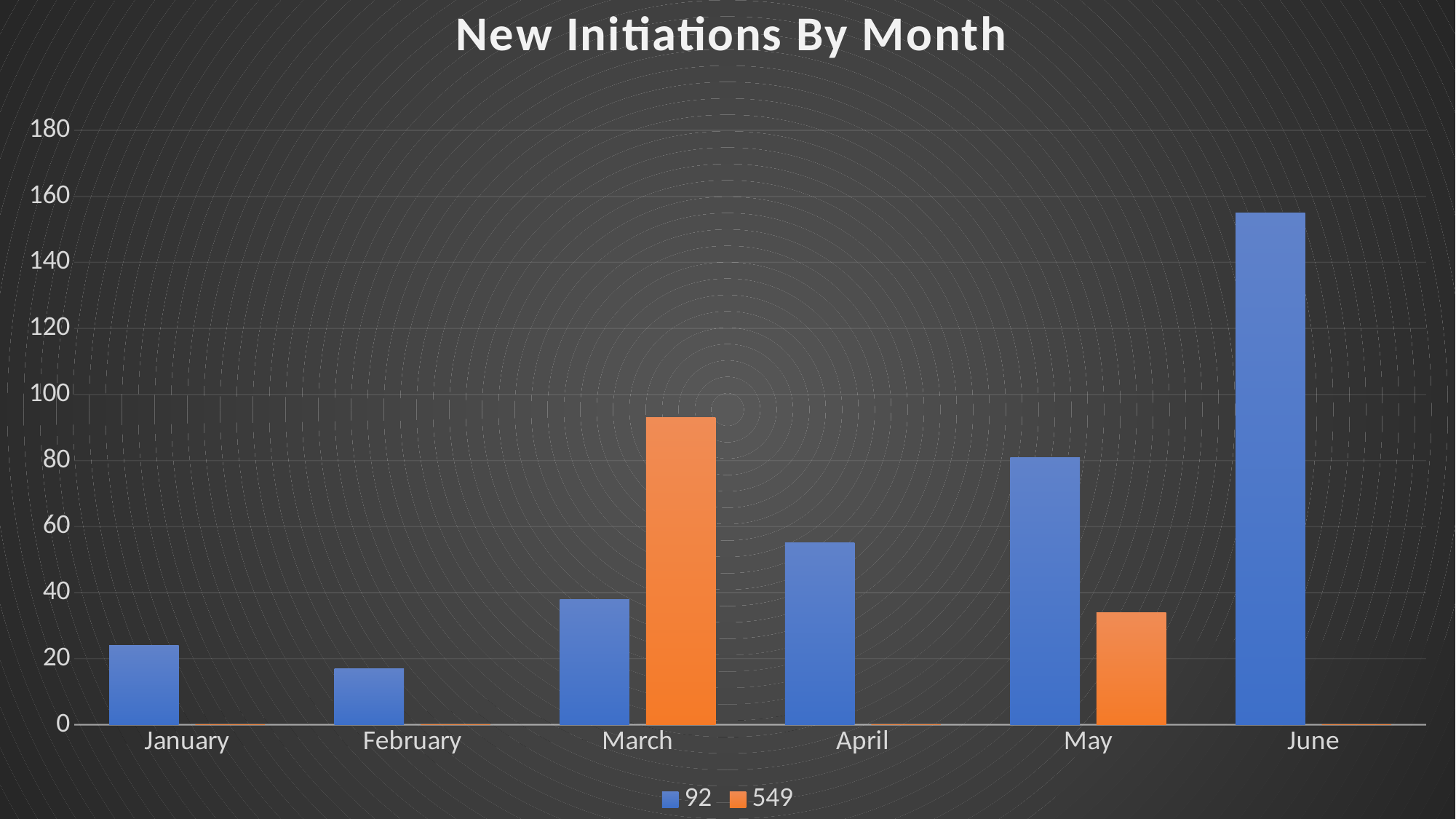
Is the value for June in the 92 series greater or less than 140? greater Is the value for January in the 92 series greater or less than 40? less What are the two series names shown in the legend? 92 and 549 Is the value for March in the 549 series greater or less than 80? greater Which month has the lowest value for the 92 series? February What is the title of the chart? New Initiations By Month In May, which series has the larger value, 92 or 549? 92 How many months are shown on the x axis? 6 Which month has the highest value for the 92 series? June How many series does the legend list? 2 In March, which series has the larger value, 92 or 549? 549 What kind of chart is shown on the slide? bar chart